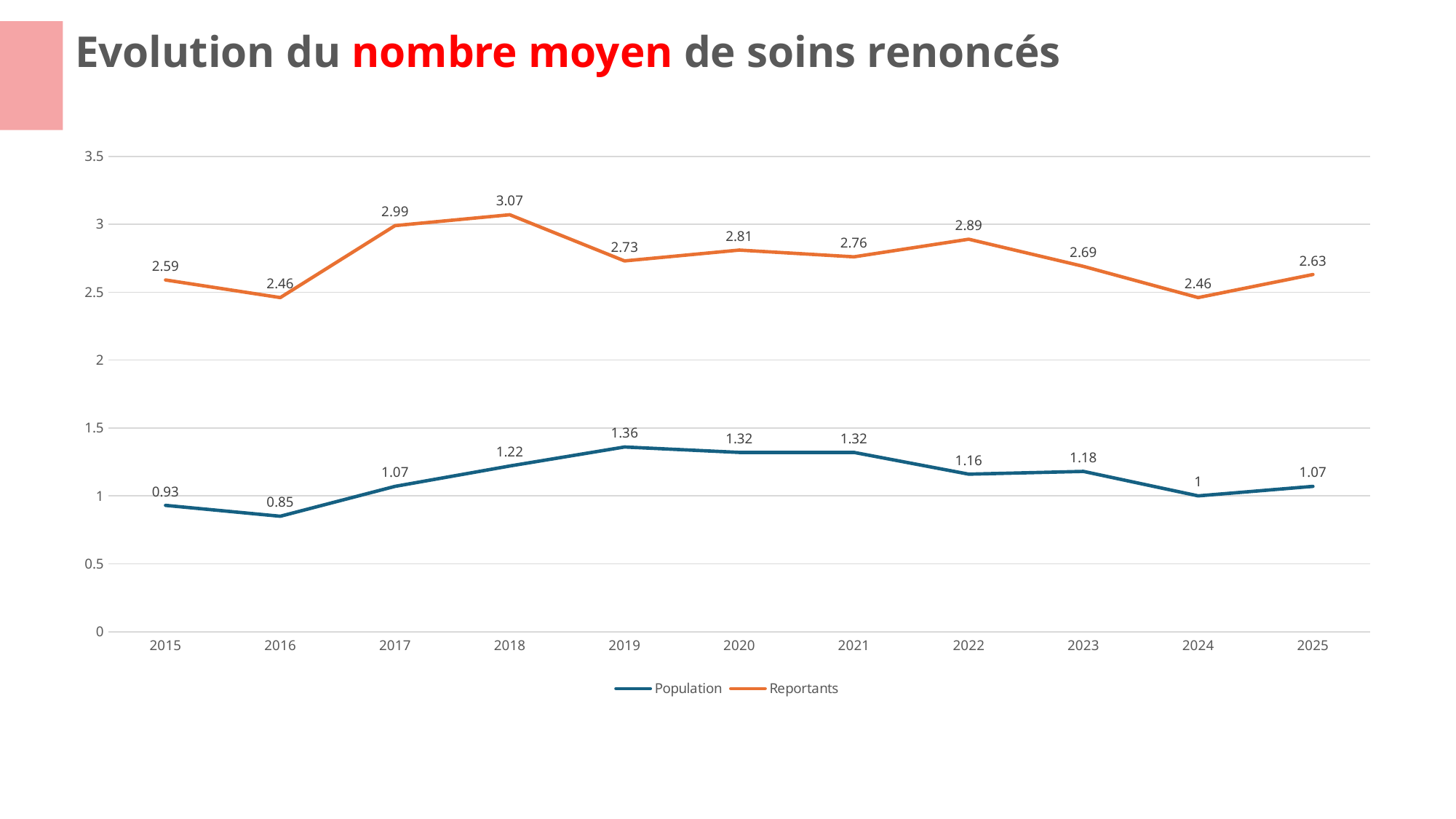
Which is larger for Reportants: the value in 2017 or the value in 2023? 2017 In which year is the Population series lowest? 2016 In which year is the Reportants series highest? 2018 What is the difference between Reportants and Population in 2019? 1.37 Does the Population series rise or fall from 2016 to 2019? rise What is the value for Population in 2016? 0.85 What is the value for Population in 2024? 1 How many years are shown on the x axis? 11 Is the value for Reportants in 2022 greater or less than 3? less How many series does the legend list? 2 What kind of chart is shown on the slide? line chart What is the value for Reportants in 2018? 3.07